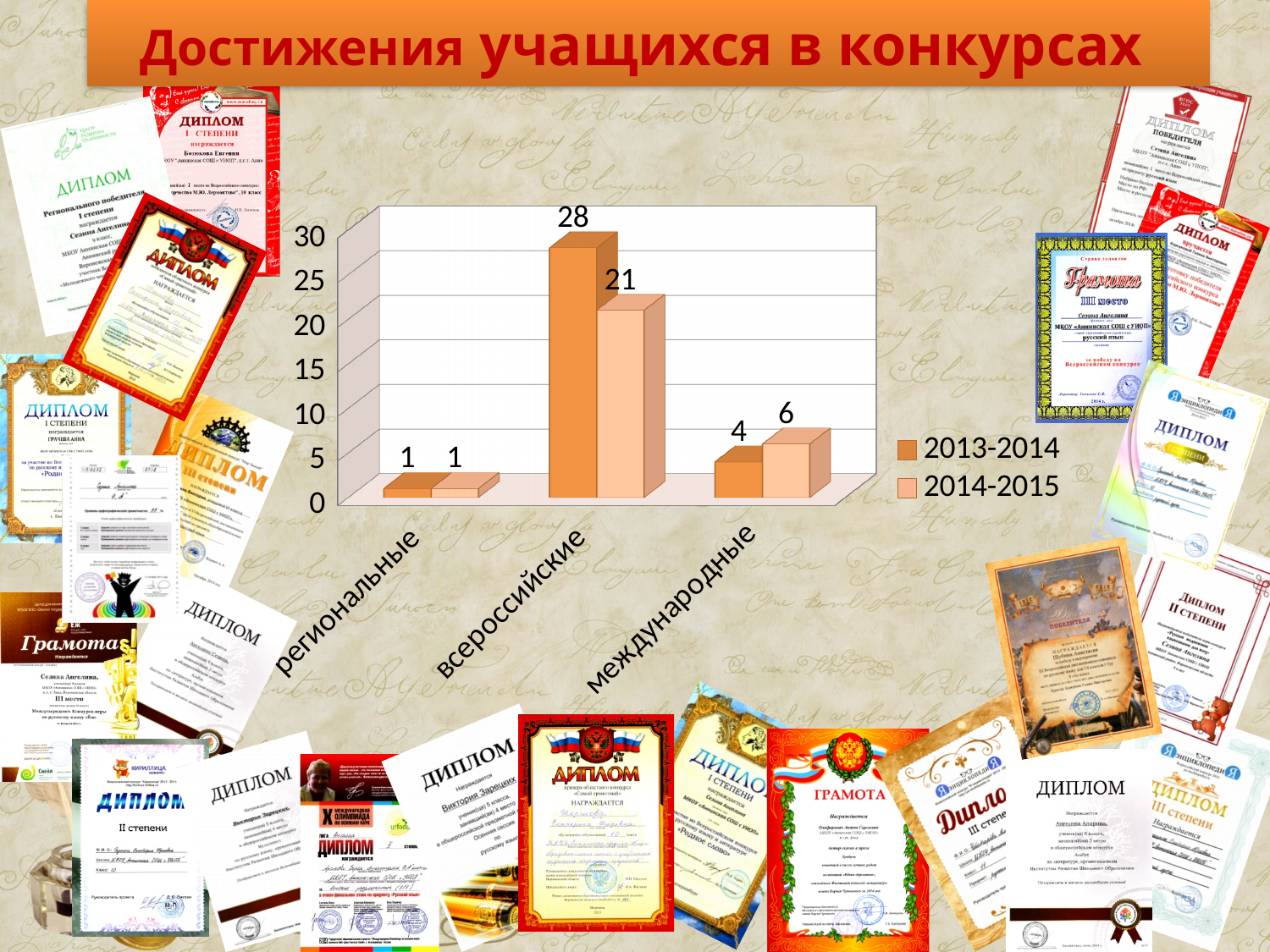
What is the value for всероссийские in the 2013-2014 series? 28 How many categories are shown on the x axis of the chart? 3 Which category has the highest value in the 2013-2014 series? всероссийские What are the two series names listed in the chart legend? 2013-2014 and 2014-2015 How many series does the chart legend list? 2 For международные, which series has the larger value, 2013-2014 or 2014-2015? 2014-2015 What kind of chart is shown on the slide? bar chart What is the value for всероссийские in the 2014-2015 series? 21 What is the value for международные in the 2014-2015 series? 6 What is the value for региональные in the 2013-2014 series? 1 What is the difference between the 2013-2014 and 2014-2015 values for всероссийские? 7 Which category has the lowest value in the 2014-2015 series? региональные